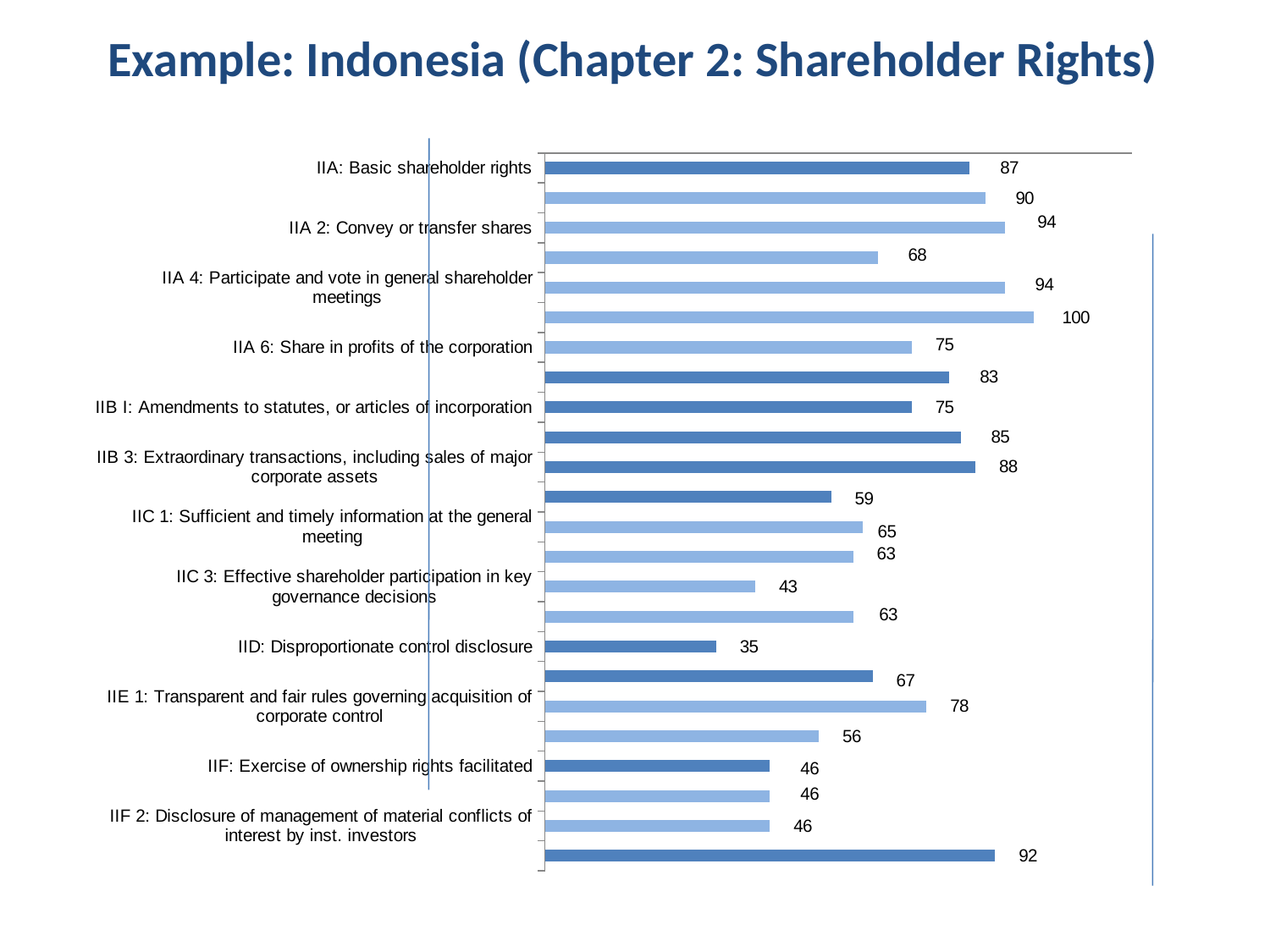
What kind of chart is shown on the slide? Bar chart What is the value for IIC 3: Effective shareholder participation in key governance decisions? 43 What is the value for IID: Disproportionate control disclosure? 35 What is the value for IIE 1: Transparent and fair rules governing acquisition of corporate control? 78 What is the highest data label value shown on the chart? 100 What is the value for IIA: Basic shareholder rights? 87 Which is larger, the value for IIB 3: Extraordinary transactions or the value for IIC 1: Sufficient and timely information at the general meeting? IIB 3: Extraordinary transactions What is the value for IIA 6: Share in profits of the corporation? 75 Which labeled category has the lowest value? IID: Disproportionate control disclosure What is the value for IIB 3: Extraordinary transactions, including sales of major corporate assets? 88 What is the value for IIA 2: Convey or transfer shares? 94 What is the difference between the values for IIA 2: Convey or transfer shares and IIA 6: Share in profits of the corporation? 19